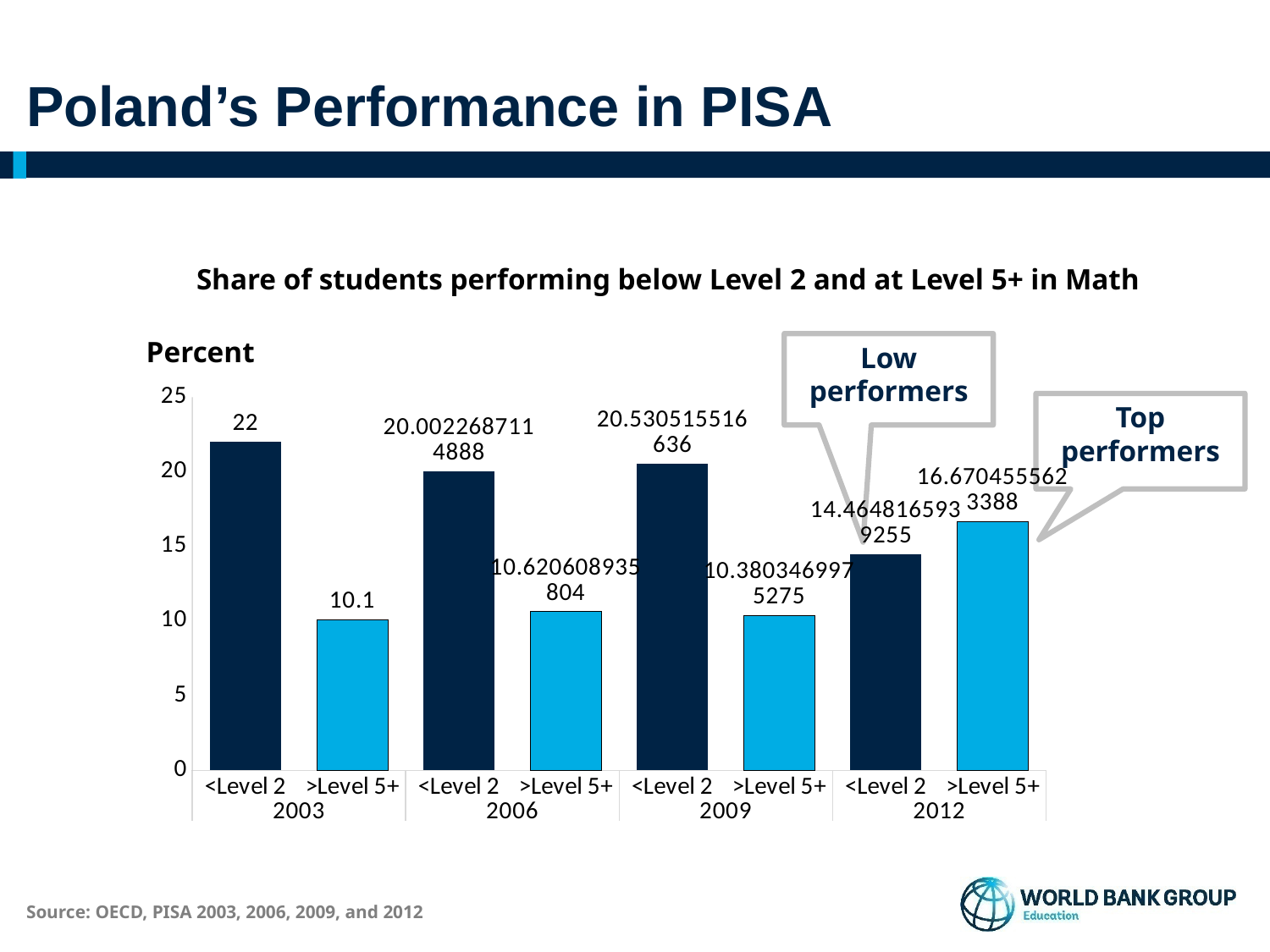
Which bar has the lowest value? >Level 5+ in 2003 What is the value for >Level 5+ in 2003? 10.1 What is the value for <Level 2 in 2012? 14.4648165939255 What is the value for <Level 2 in 2003? 22 What is the value for >Level 5+ in 2012? 16.6704555623388 What is the difference between the <Level 2 and >Level 5+ values in 2003? 11.9 Which bar has the highest value? <Level 2 in 2003 In 2012, which is larger: the <Level 2 value or the >Level 5+ value? >Level 5+ How many bars are plotted in the chart? 8 What is the title of the chart? Share of students performing below Level 2 and at Level 5+ in Math Is the value for <Level 2 in 2009 greater or less than 15? greater What type of chart is shown on the slide? bar chart